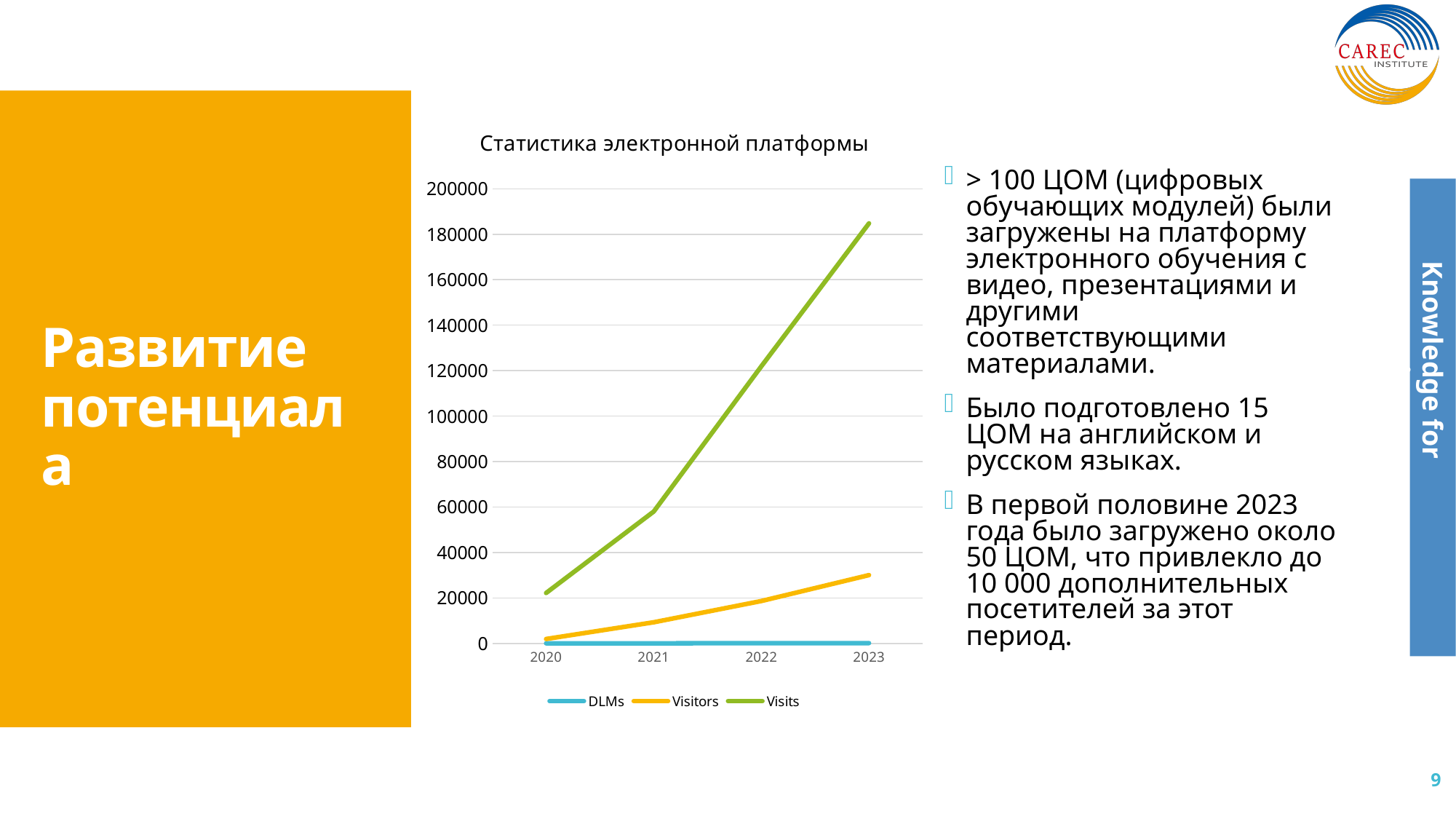
Which series has the lowest values across all years? DLMs Which is larger in 2022, the Visits value or the Visitors value? Visits Which series are listed in the chart legend? DLMs, Visitors, Visits How many series does the chart legend list? 3 What kind of chart is shown on the slide? line chart Is the Visits value for 2023 greater or less than 160000? greater Is the Visitors value for 2023 greater or less than 20000? greater What is the title of the chart? Статистика электронной платформы Is the Visits value for 2021 greater or less than 80000? less How many years are shown on the x axis of the chart? 4 Which series has the highest value in 2023? Visits Do the Visits values rise or fall from 2020 to 2023? rise